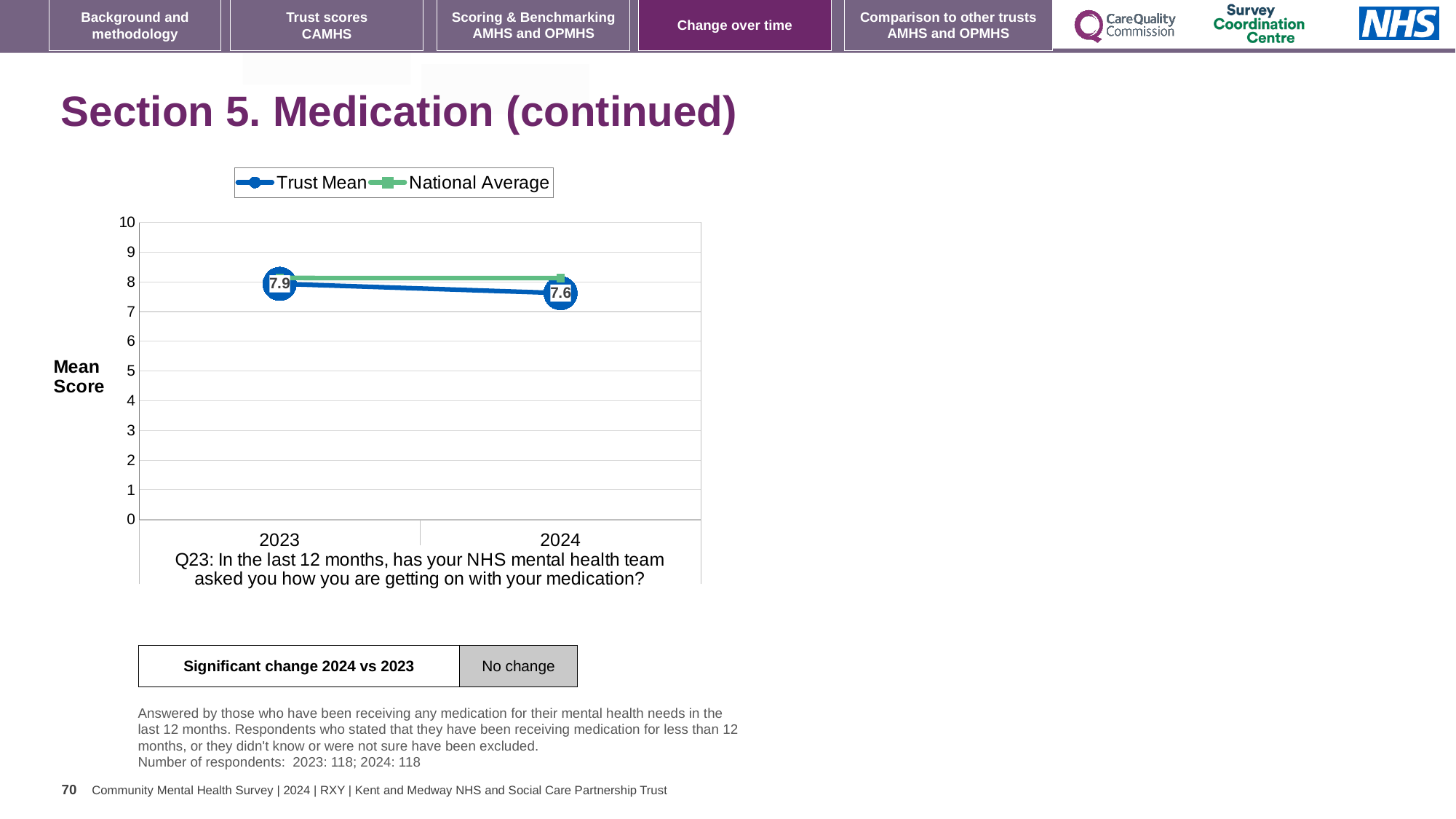
Which is larger in 2024, the Trust Mean or the National Average? National Average What is the label on the y axis of the chart? Mean Score What is the difference between the Trust Mean in 2023 and in 2024? 0.3 What is the Trust Mean value for 2024? 7.6 What kind of chart is shown on the slide? line chart How many series does the chart legend list? 2 How many years are shown on the x axis of the chart? 2 In which year is the Trust Mean highest? 2023 Does the Trust Mean rise or fall from 2023 to 2024? fall In which year is the Trust Mean lowest? 2024 Is the National Average value for 2024 greater or less than 7? greater What is the Trust Mean value for 2023? 7.9